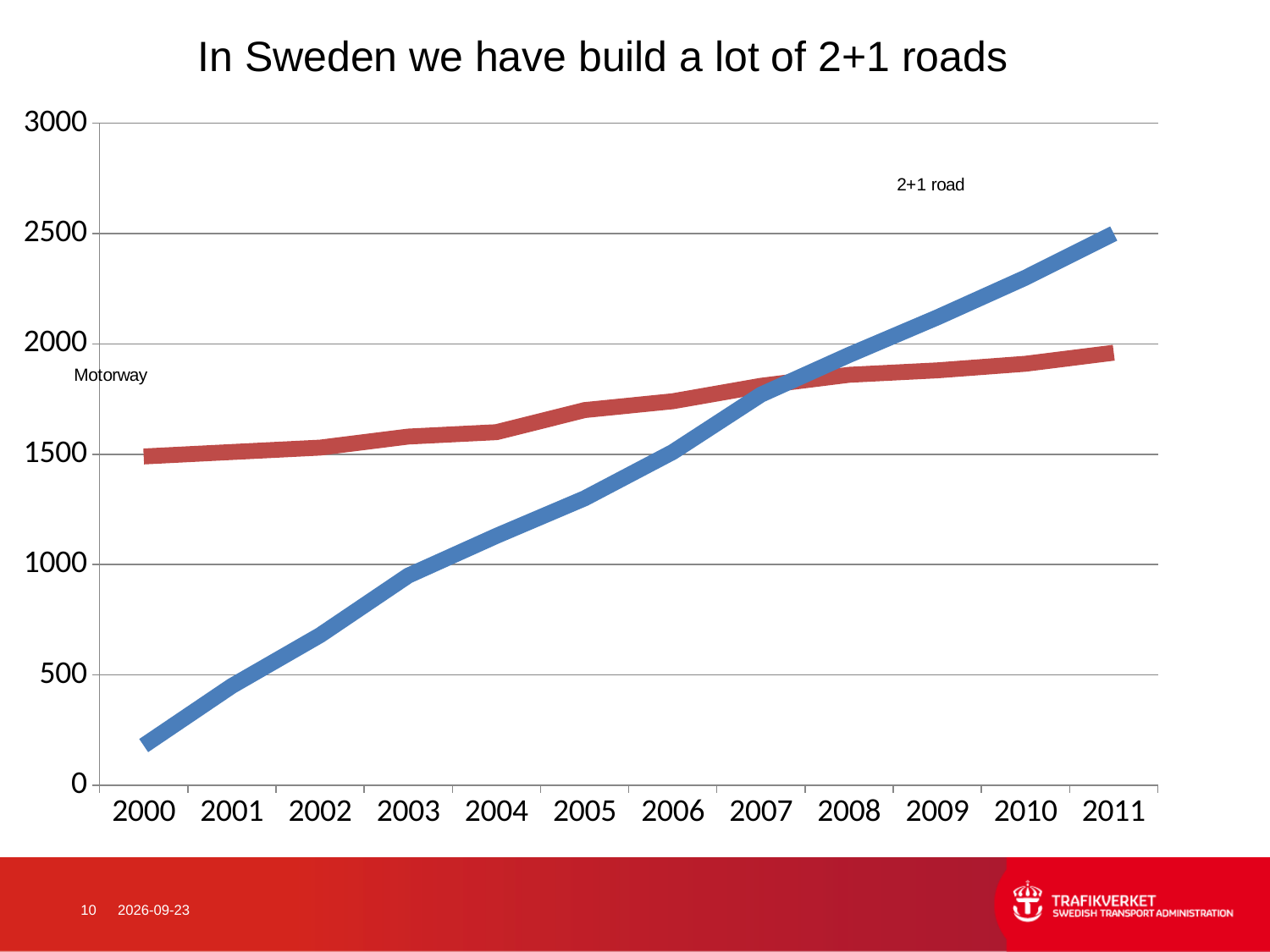
Is the value for 2+1 road in 2000 greater or less than 500? less Is the value for 2+1 road in 2011 greater or less than 2000? greater How many years are shown along the x axis of the chart? 12 In 2000, which series has the larger value, Motorway or 2+1 road? Motorway In 2011, which series has the larger value, Motorway or 2+1 road? 2+1 road Does the Motorway series rise or fall from 2000 to 2011? rise Does the 2+1 road series rise or fall from 2000 to 2011? rise Is the value for Motorway in 2000 greater or less than 1000? greater How many series are plotted on the chart? 2 What is the title of the slide? In Sweden we have build a lot of 2+1 roads What kind of chart is shown on the slide? line chart